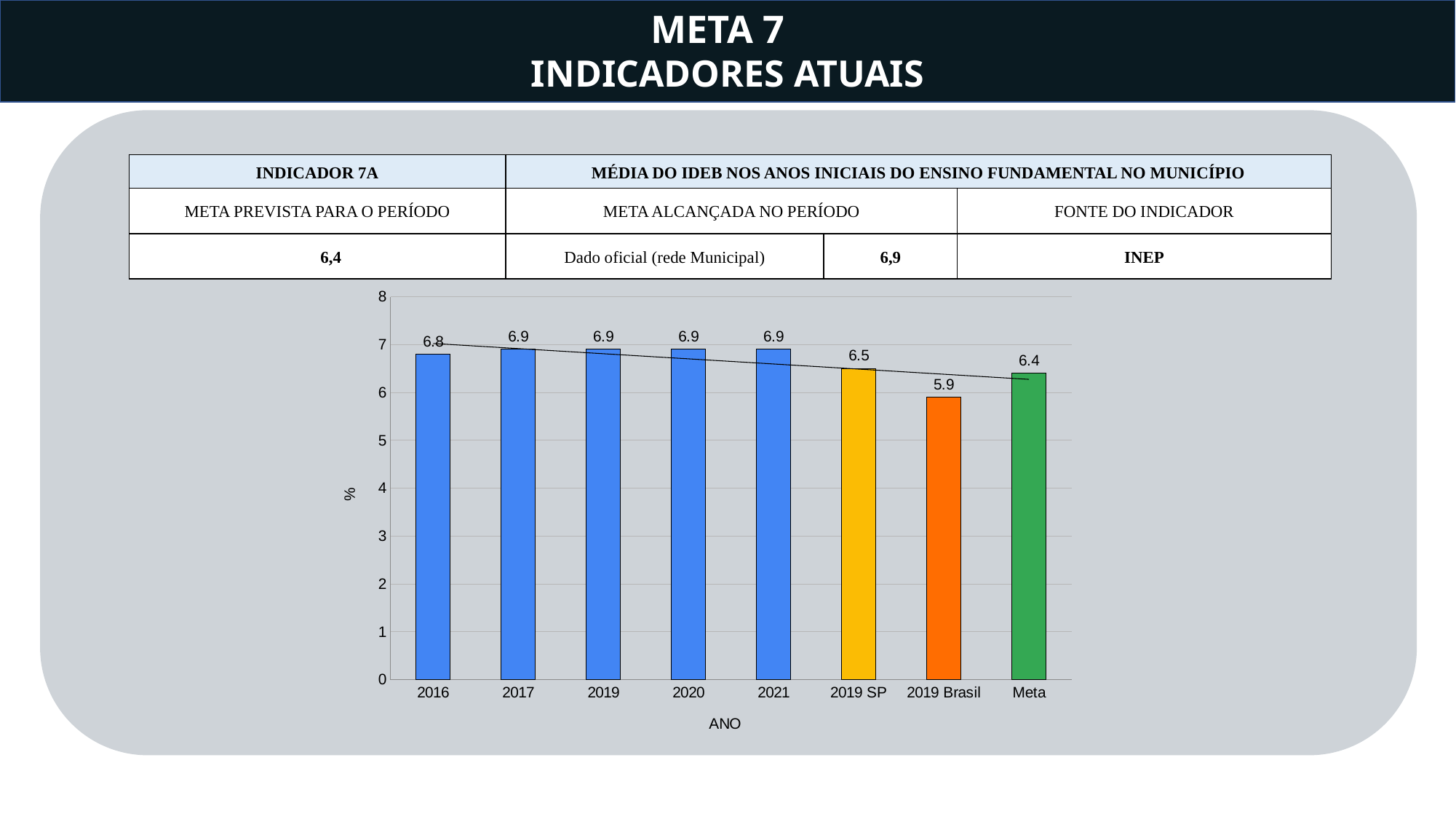
How many bars are shown in the chart? 8 What is the difference between the values for 2021 and 2019 Brasil? 1.0 What is the value for 2016 in the bar chart? 6.8 Which category has the lowest value in the bar chart? 2019 Brasil What is the difference between the values for 2019 SP and Meta? 0.1 What is the value for 2019 SP in the bar chart? 6.5 What kind of chart is shown on the slide? bar chart What is the value for Meta in the bar chart? 6.4 What is the label of the x axis of the chart? ANO What is the value for 2019 Brasil in the bar chart? 5.9 Is the value for 2019 Brasil greater or less than 6? less Which is larger, the value for 2019 SP or the value for 2019 Brasil? 2019 SP